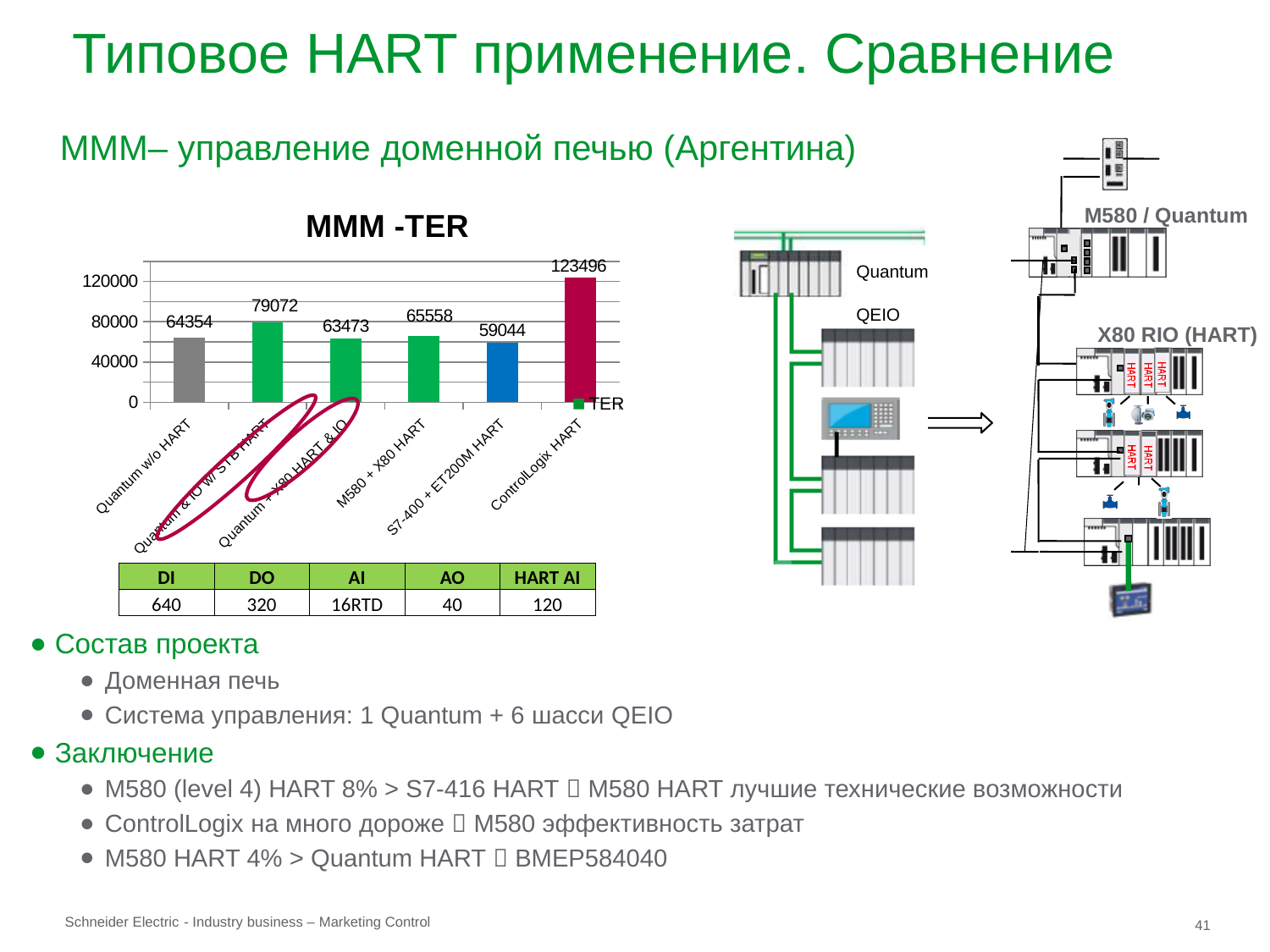
In the MMM -TER chart, which category has the highest value? ControlLogix HART In the MMM -TER chart, what is the value for M580 + X80 HART? 65558 How many categories (bars) are shown in the MMM -TER chart? 6 What kind of chart is the MMM -TER chart? bar chart In the MMM -TER chart, what is the difference between the values for ControlLogix HART and M580 + X80 HART? 57938 In the MMM -TER chart, which category has the lowest value? S7-400 + ET200M HART In the MMM -TER chart, is the value for ControlLogix HART greater or less than 120000? greater In the MMM -TER chart, what is the value for Quantum w/o HART? 64354 In the MMM -TER chart, what is the value for S7-400 + ET200M HART? 59044 In the MMM -TER chart, what is the value for ControlLogix HART? 123496 How many series does the legend of the MMM -TER chart list? 1 In the MMM -TER chart, which is larger: the value for M580 + X80 HART or the value for Quantum w/o HART? M580 + X80 HART